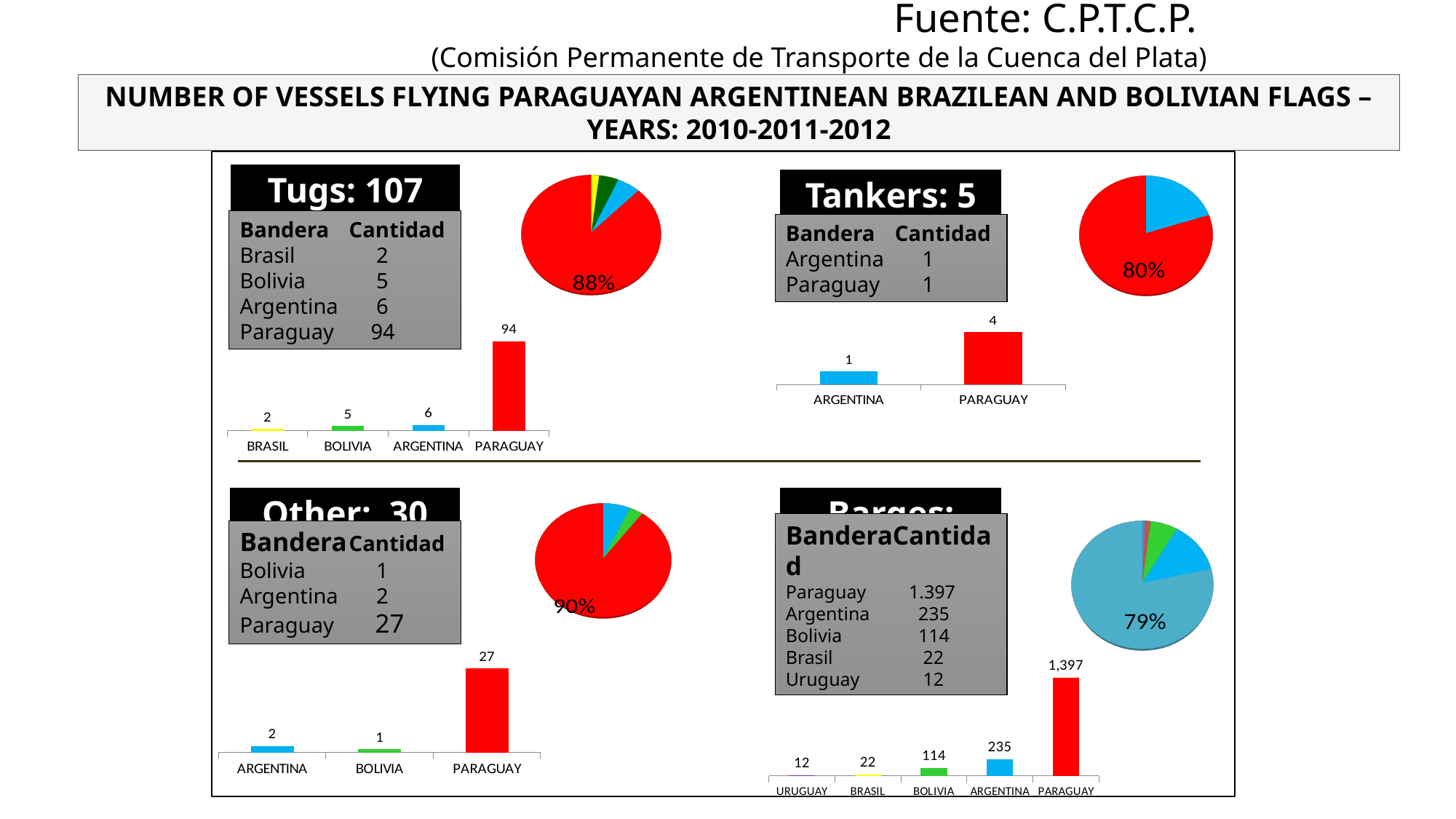
In the Tugs bar chart (top left), what is the value for PARAGUAY? 94 In the Tugs bar chart (top left), which category has the lowest value? BRASIL How many categories are shown in the Barges bar chart (bottom right)? 5 In the Barges bar chart (bottom right), what is the difference between the values for BOLIVIA and BRASIL? 92 In the Barges bar chart (bottom right), what is the value for ARGENTINA? 235 In the Other bar chart (bottom left), which is larger, the value for ARGENTINA or the value for BOLIVIA? ARGENTINA In the Tankers bar chart (top right), what is the difference between the values for PARAGUAY and ARGENTINA? 3 In the Tugs pie chart (top left), what percentage is labelled on the largest slice? 88% What kind of chart is the chart at the bottom right showing URUGUAY, BRASIL, BOLIVIA, ARGENTINA and PARAGUAY? bar chart In the Other bar chart (bottom left), which category has the highest value? PARAGUAY How many categories are shown in the Tugs bar chart (top left)? 4 In the Tankers bar chart (top right), what is the value for PARAGUAY? 4